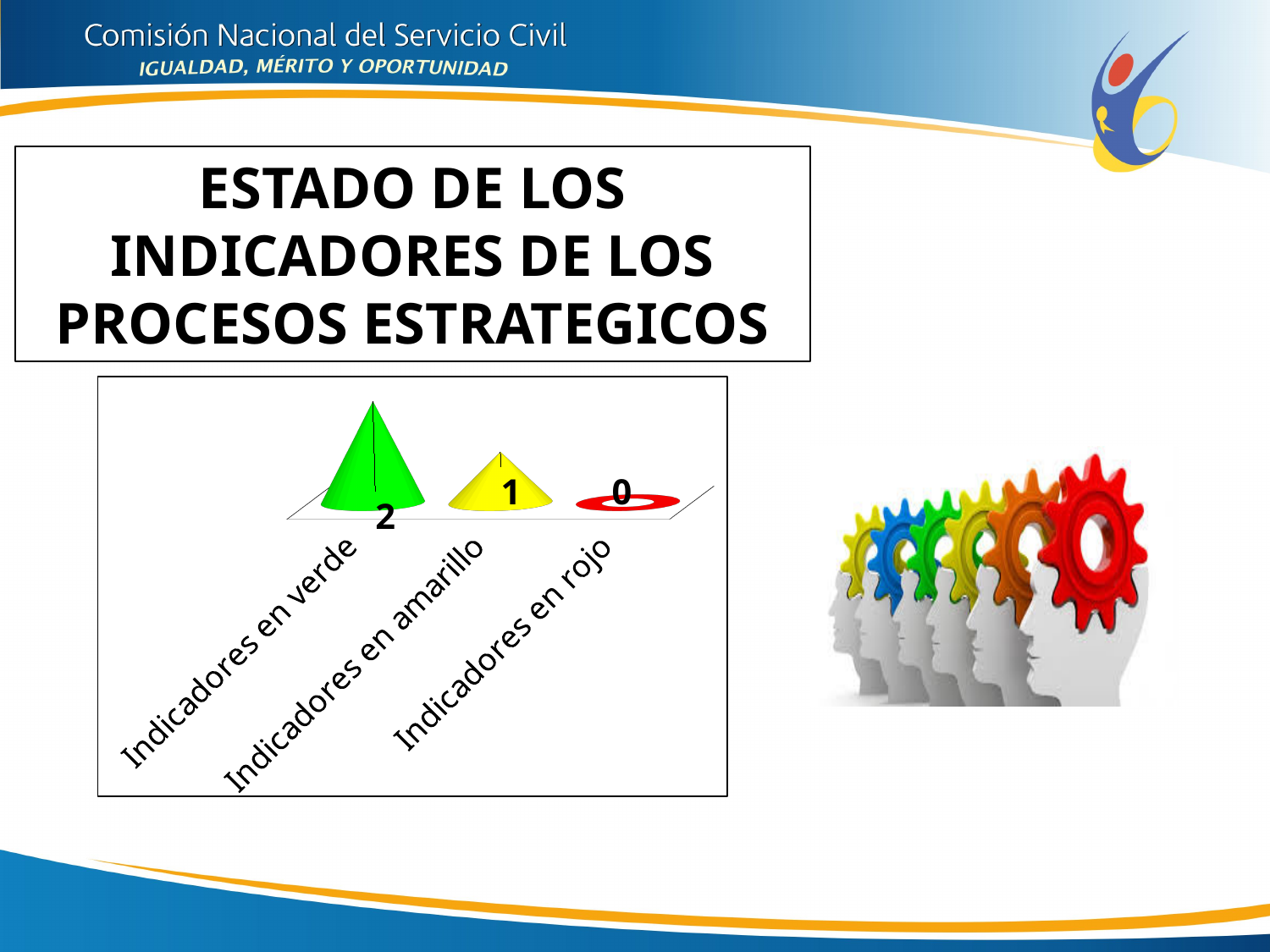
Which category has the lowest value? Indicadores en rojo What is the difference between the values for Indicadores en verde and Indicadores en amarillo? 1 Which category has the highest value? Indicadores en verde What is the difference between the values for Indicadores en verde and Indicadores en rojo? 2 What colour is the cone for Indicadores en amarillo? yellow What is the total of the three values shown in the chart? 3 What is the value for Indicadores en verde? 2 How many categories are shown in the chart? 3 Which is larger, the value for Indicadores en amarillo or the value for Indicadores en rojo? Indicadores en amarillo Do the values rise or fall from left to right across the categories? fall What is the value for Indicadores en rojo? 0 What is the value for Indicadores en amarillo? 1